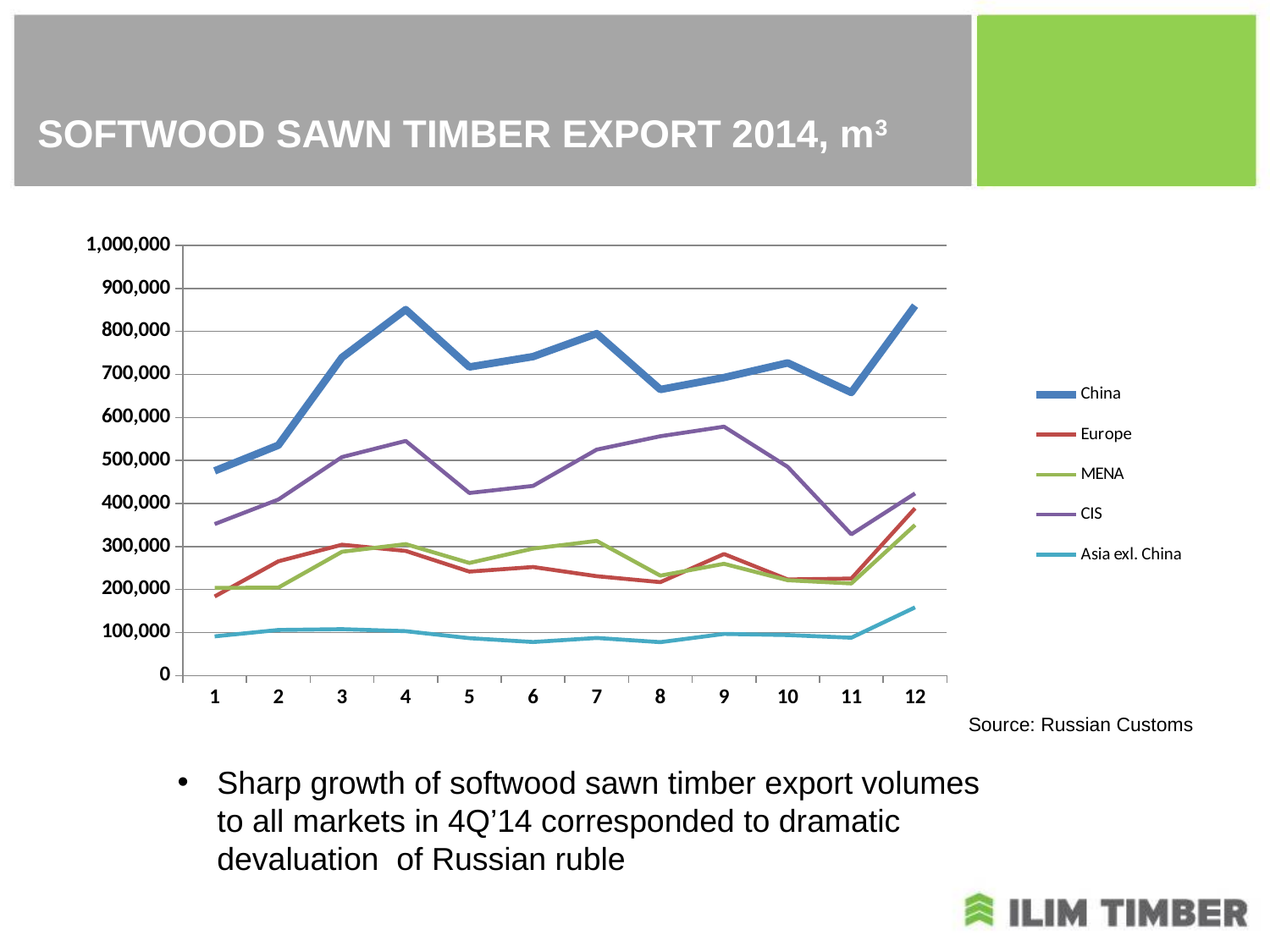
Which series has the lowest values across all months? Asia exl. China What kind of chart is shown on the slide? line chart Is the value for CIS in month 11 greater or less than 400,000? less Is the value for China in month 4 greater or less than 800,000? greater In which month is the value for CIS lowest? 11 Do the values for China rise or fall from month 1 to month 4? rise Is the value for Asia exl. China in month 12 greater or less than 100,000? greater In month 7, which is larger, the value for MENA or the value for Europe? MENA In which month is the value for China lowest? 1 How many points are plotted along the x axis for each series? 12 How many series does the legend list? 5 Which series has the highest values across all months? China